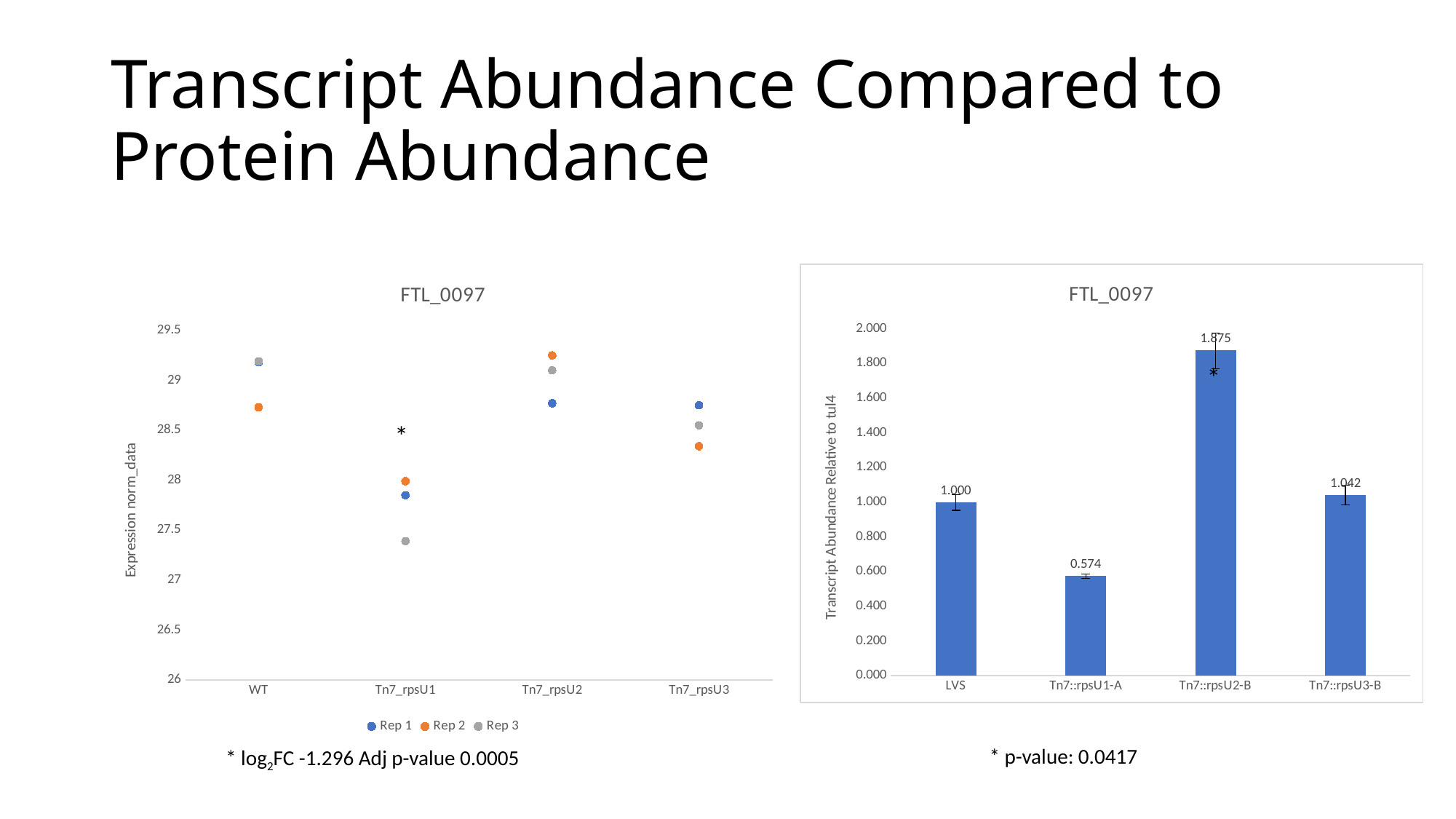
What kind of chart is the chart on the right of the slide? Bar chart On the right-hand bar chart, which is larger, the value for Tn7::rpsU3-B or the value for Tn7::rpsU1-A? Tn7::rpsU3-B On the right-hand bar chart, how many categories are shown on the x axis? 4 On the right-hand bar chart, what is the difference between the values for Tn7::rpsU2-B and LVS? 0.875 On the right-hand bar chart, which category has the lowest value? Tn7::rpsU1-A On the right-hand bar chart, which category has the highest value? Tn7::rpsU2-B On the left-hand chart, is the Rep 3 value for Tn7_rpsU1 greater or less than 27.5? less On the left-hand chart, how many series does the legend list? 3 What is the y-axis label of the right-hand bar chart? Transcript Abundance Relative to tul4 On the right-hand bar chart, what is the value for Tn7::rpsU2-B? 1.875 On the right-hand bar chart, what is the value for Tn7::rpsU1-A? 0.574 On the right-hand bar chart, what is the value for LVS? 1.000